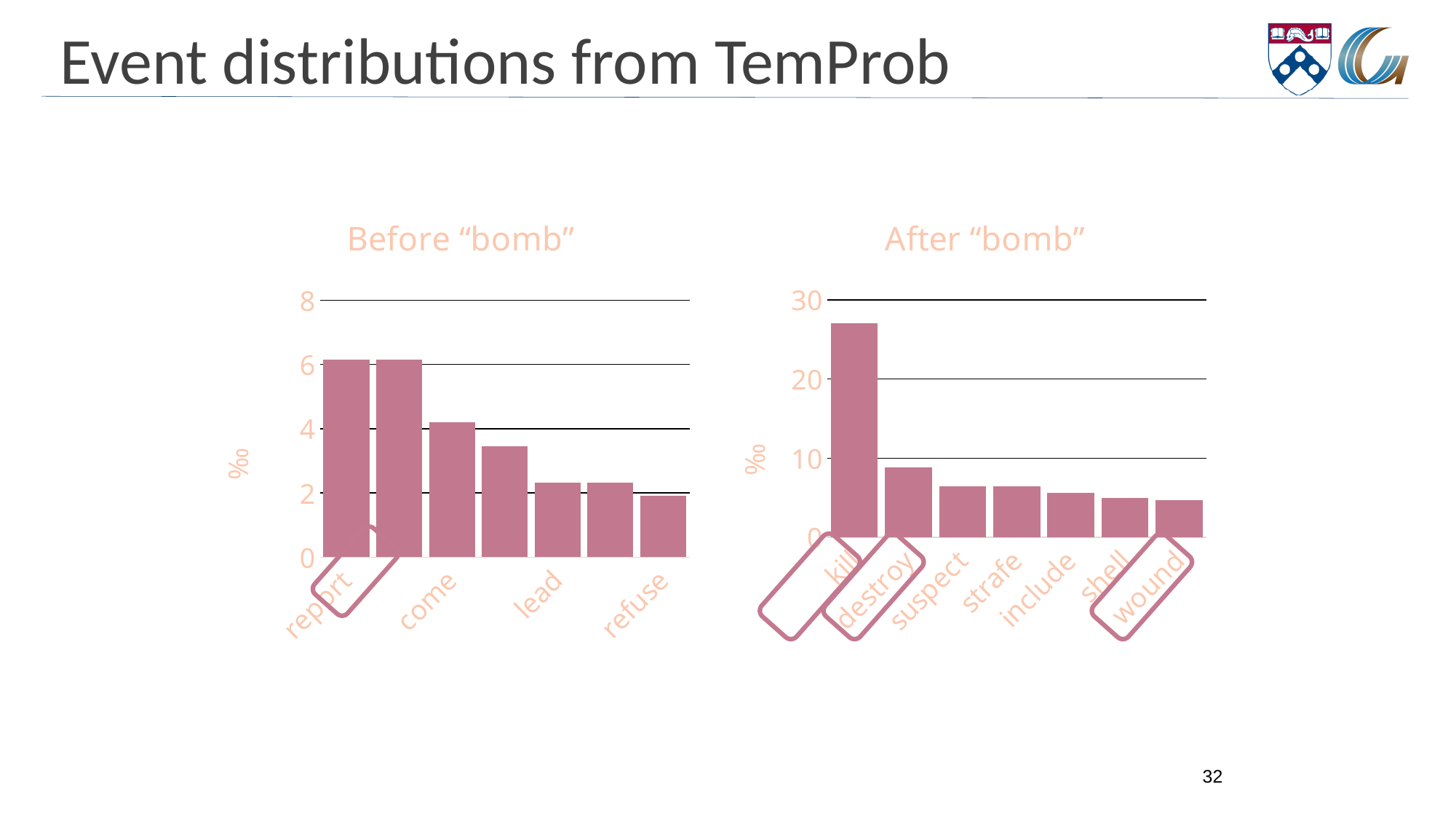
How many bars does the "Before "bomb"" chart have? 7 How many bars does the "After "bomb"" chart have? 7 In the "After "bomb"" chart, which is larger, kill or destroy? kill In the "After "bomb"" chart, is the value for suspect greater or less than 10? less In the "After "bomb"" chart, is the value for kill greater or less than 20? greater In the "Before "bomb"" chart, which is larger, come or lead? come In the "Before "bomb"" chart, is the value for report greater or less than 4? greater In the "After "bomb"" chart, do the values rise or fall from left to right? fall What kind of chart is the "Before "bomb"" chart? bar chart What unit is shown on the y-axis of the "Before "bomb"" chart? ‰ In the "After "bomb"" chart, which category has the highest value? kill